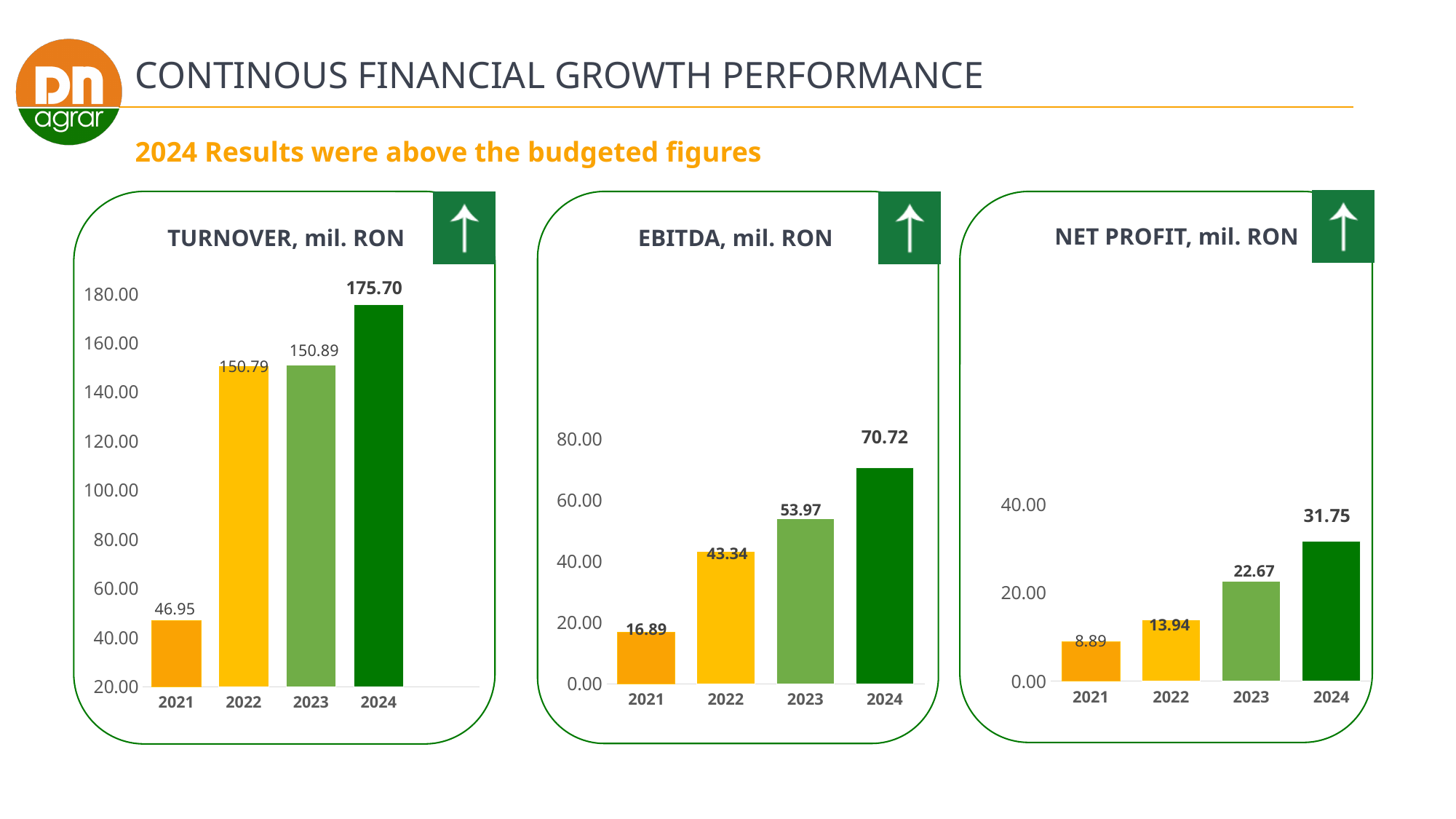
In the NET PROFIT, mil. RON chart, which is larger, the value for 2023 or the value for 2024? 2024 In the EBITDA, mil. RON chart, which year has the highest value? 2024 In the TURNOVER, mil. RON chart, what is the value for 2024? 175.70 In the TURNOVER, mil. RON chart, what is the value for 2021? 46.95 What kind of chart is the EBITDA, mil. RON chart? bar chart How many years are shown in the NET PROFIT, mil. RON chart? 4 In the EBITDA, mil. RON chart, what is the difference between the 2024 and 2021 values? 53.83 In the TURNOVER, mil. RON chart, what is the difference between the 2024 and 2023 values? 24.81 In the EBITDA, mil. RON chart, what is the value for 2023? 53.97 In the EBITDA, mil. RON chart, is the value for 2022 greater or less than 40.00? greater In the NET PROFIT, mil. RON chart, which year has the lowest value? 2021 In the NET PROFIT, mil. RON chart, what is the value for 2022? 13.94